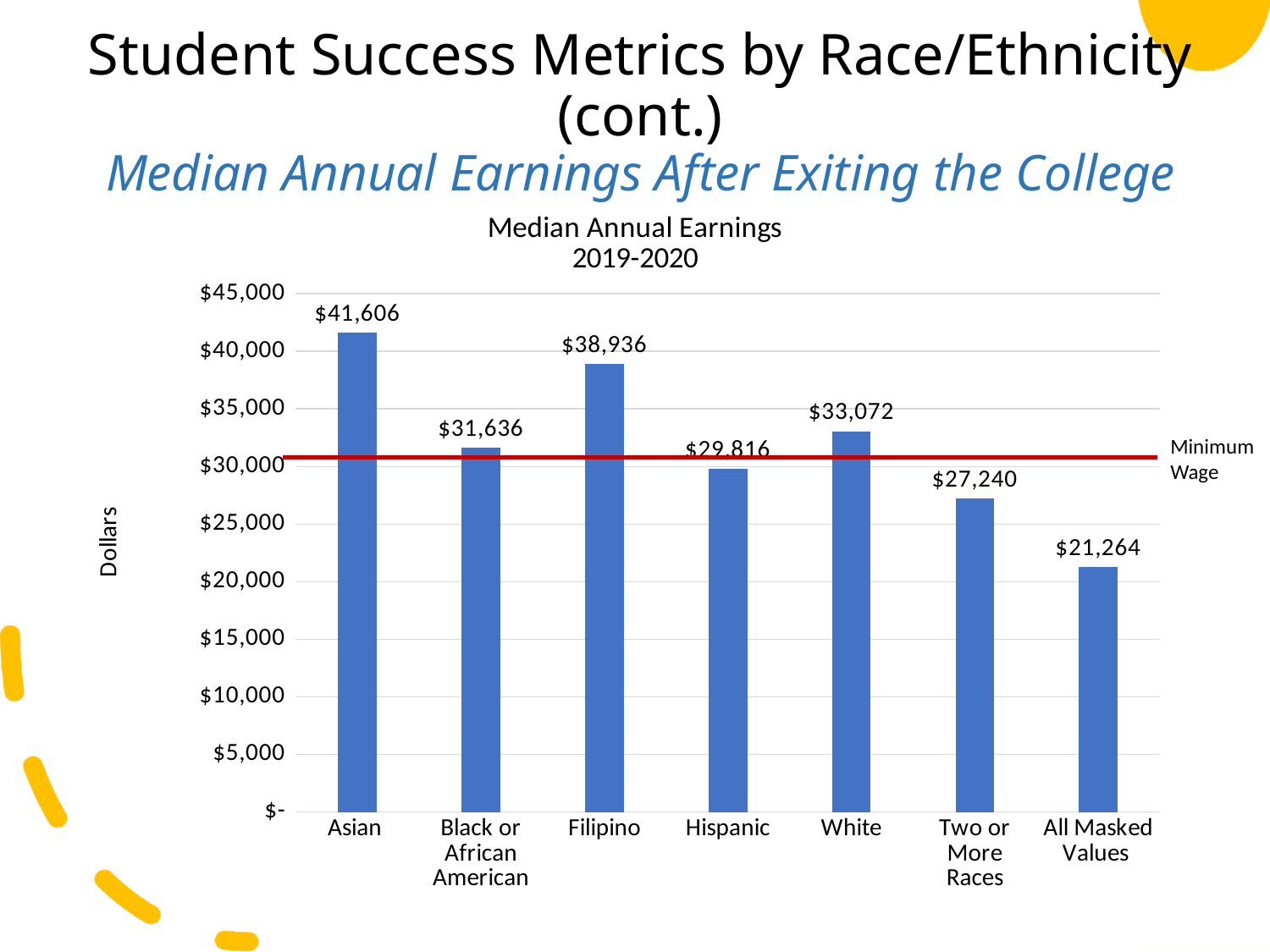
What does the red horizontal line on the chart represent? Minimum Wage What is the difference between the median annual earnings for White and Hispanic students? $3,256 What is the median annual earnings value for Filipino students? $38,936 What kind of chart is shown on the slide? bar chart How many race/ethnicity categories are shown on the chart? 7 Is the value for Hispanic greater or less than $30,000? less Which category has the highest median annual earnings? Asian What is the median annual earnings value for Asian students? $41,606 Which is larger, the median annual earnings for Black or African American students or for White students? White What is the difference between the median annual earnings for Asian and Filipino students? $2,670 Which category has the lowest median annual earnings? All Masked Values What is the median annual earnings value for Two or More Races? $27,240